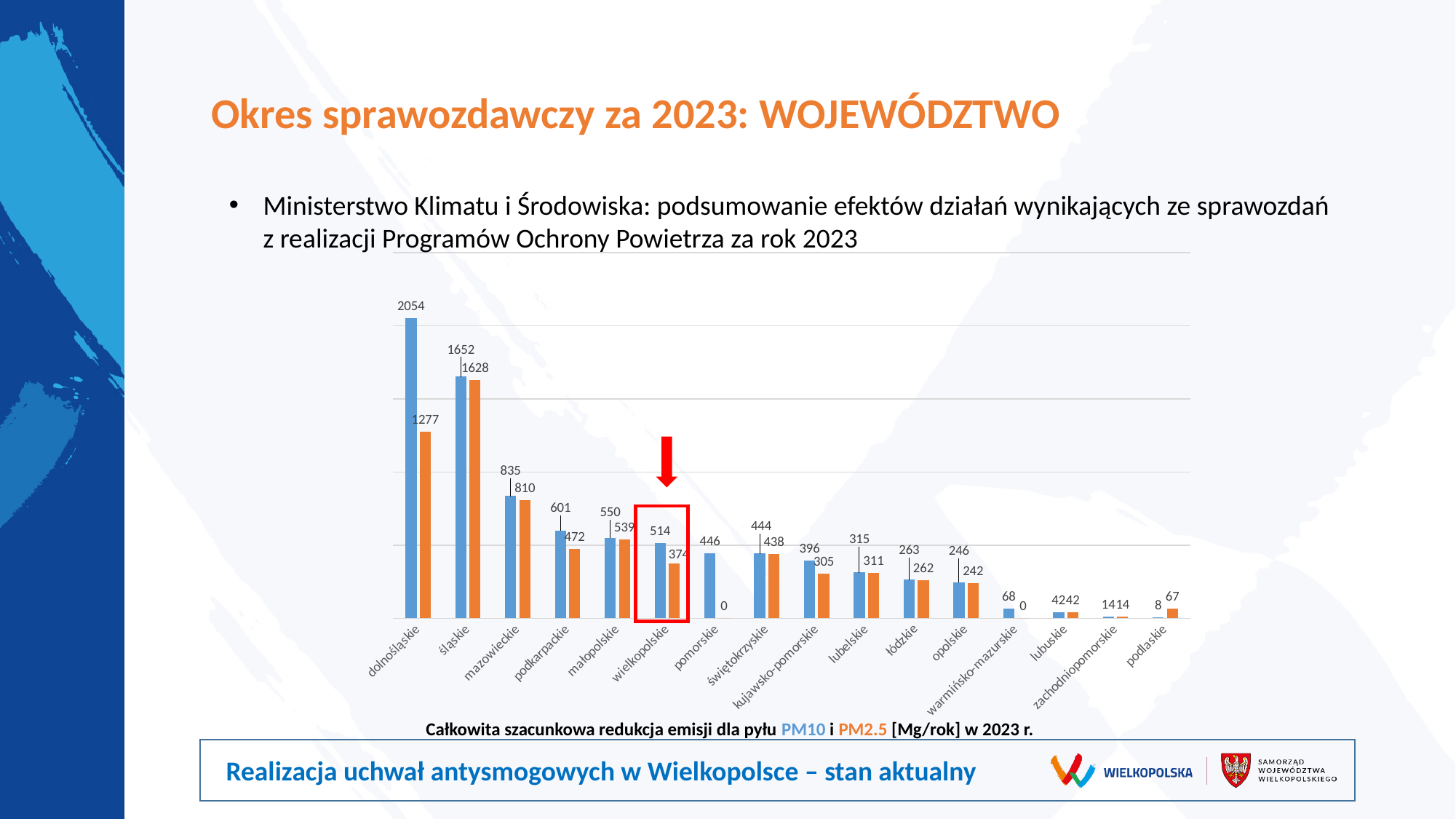
Which colour represents PM2.5 in the chart? orange What is the PM10 reduction value for wielkopolskie? 514 What is the PM2.5 reduction value for podlaskie? 67 What kind of chart is shown on the slide? bar chart How many voivodeships are shown on the x axis of the chart? 16 What is the difference between the PM10 values for dolnośląskie and śląskie? 402 Which voivodeship has the lowest PM10 reduction value? podlaskie What is the difference between the PM10 and PM2.5 values for wielkopolskie? 140 Which voivodeship has the highest PM2.5 reduction value? śląskie Which voivodeship has the highest PM10 reduction value? dolnośląskie Which is larger: the PM10 value for mazowieckie or the PM10 value for podkarpackie? mazowieckie What is the PM2.5 reduction value for dolnośląskie? 1277